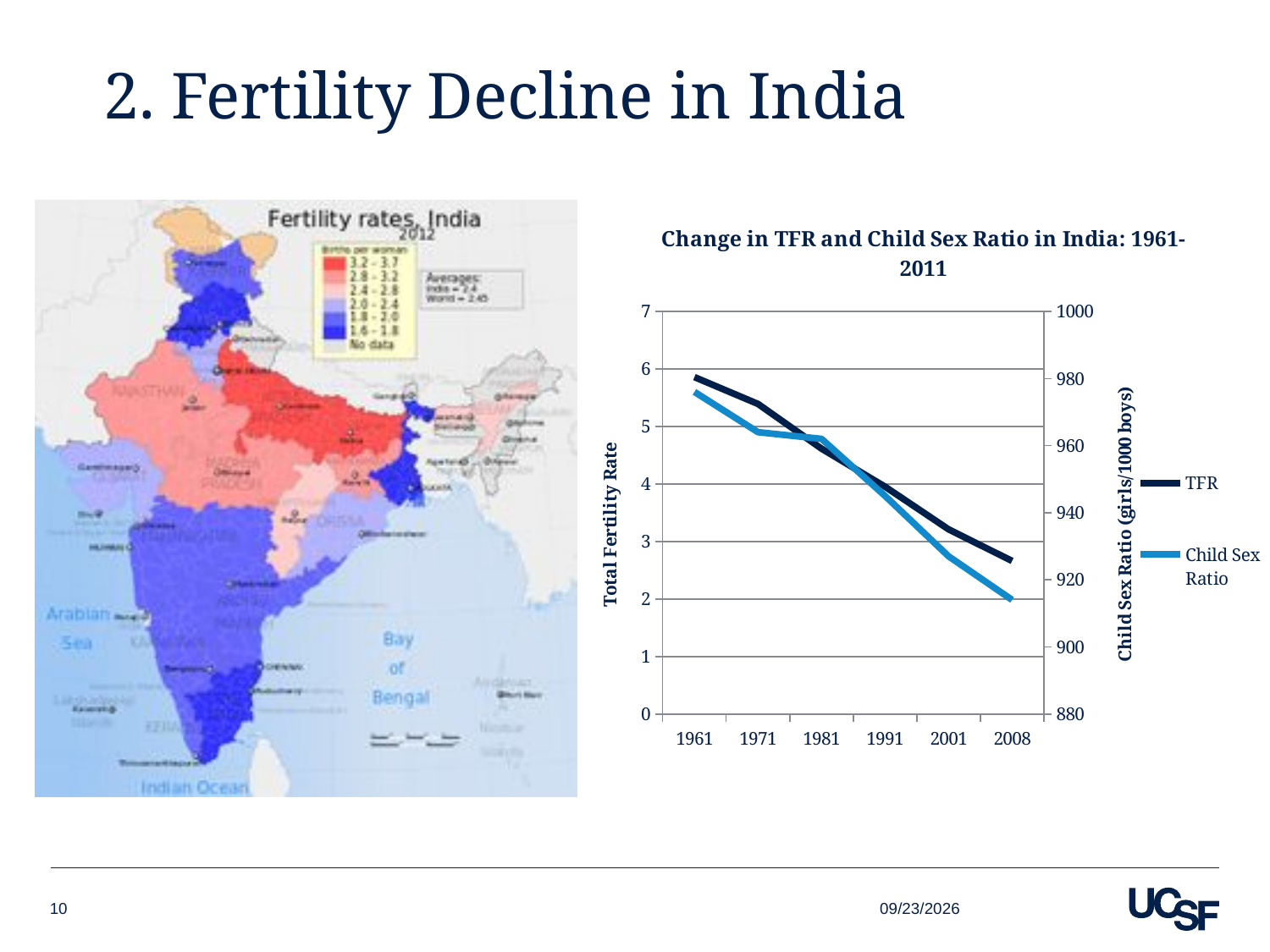
In the line chart, does the TFR series rise or fall from 1961 to 2008? fall What kind of chart is the chart titled "Change in TFR and Child Sex Ratio in India: 1961-2011"? line chart What is the label of the right-hand vertical axis of the line chart? Child Sex Ratio (girls/1000 boys) In the line chart, is the TFR value for 1961 greater or less than 5? greater How many years are marked on the x axis of the line chart? 6 In the line chart, is the Child Sex Ratio value for 2008 greater or less than 920? less In the line chart, is the TFR value for 2008 greater or less than 3? less In the line chart, which year has the highest TFR? 1961 How many series does the legend of the line chart list? 2 In the line chart, does the Child Sex Ratio series rise or fall from 1961 to 2008? fall In the line chart, which year has the lowest Child Sex Ratio? 2008